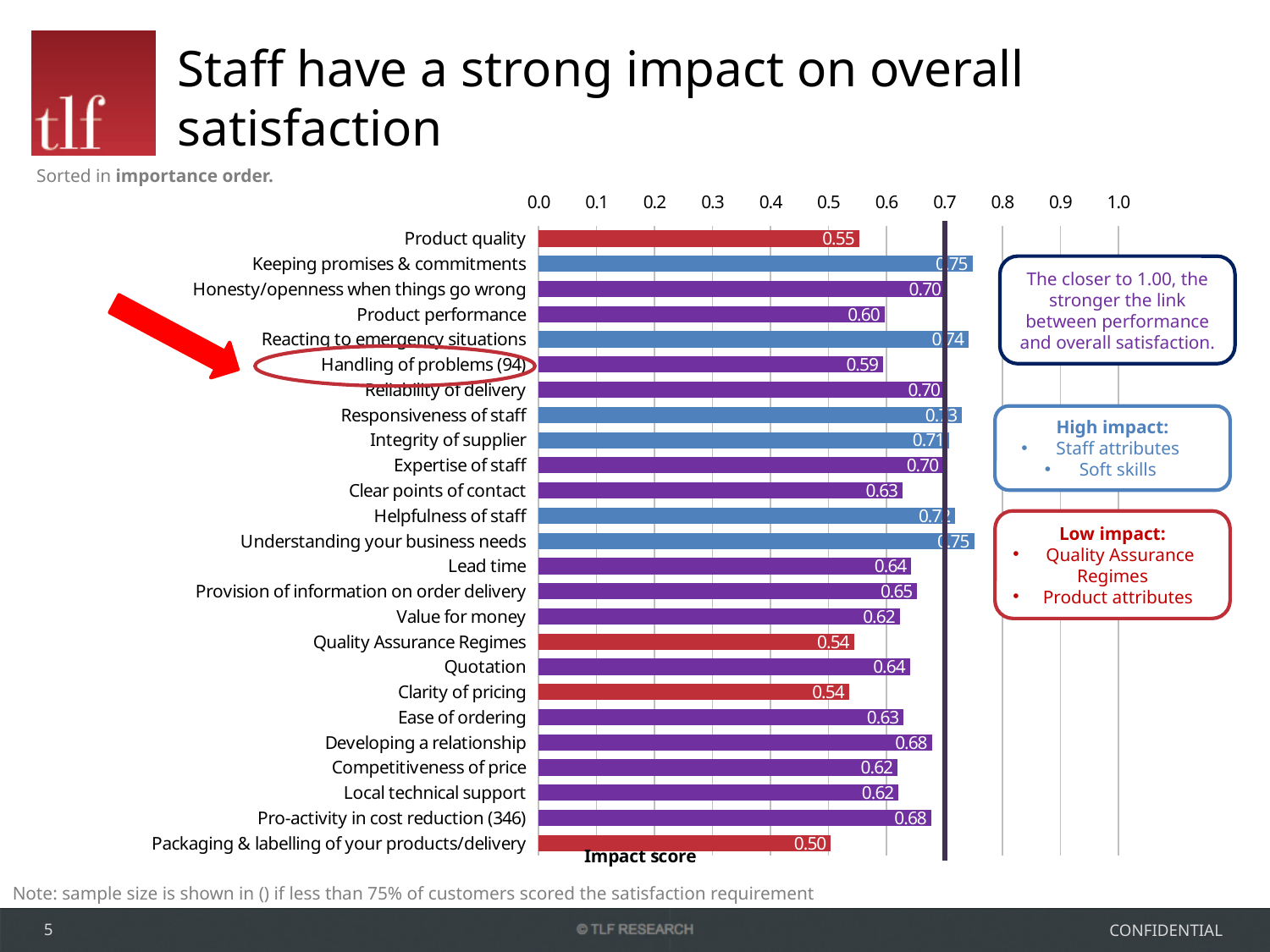
What is the impact score for Handling of problems (94)? 0.59 What is the impact score for Product quality? 0.55 Which category has the lowest impact score? Packaging & labelling of your products/delivery Is the impact score for Keeping promises & commitments greater or less than 0.7? greater Which has a higher impact score, Lead time or Value for money? Lead time What is the difference between the impact scores for Developing a relationship and Product quality? 0.13 What kind of chart is shown on the slide? Bar chart What is the label on the horizontal axis of the chart? Impact score What is the impact score for Quality Assurance Regimes? 0.54 What is the impact score for Developing a relationship? 0.68 How many categories are shown in the chart? 25 What is the difference between the impact scores for Integrity of supplier and Clear points of contact? 0.08